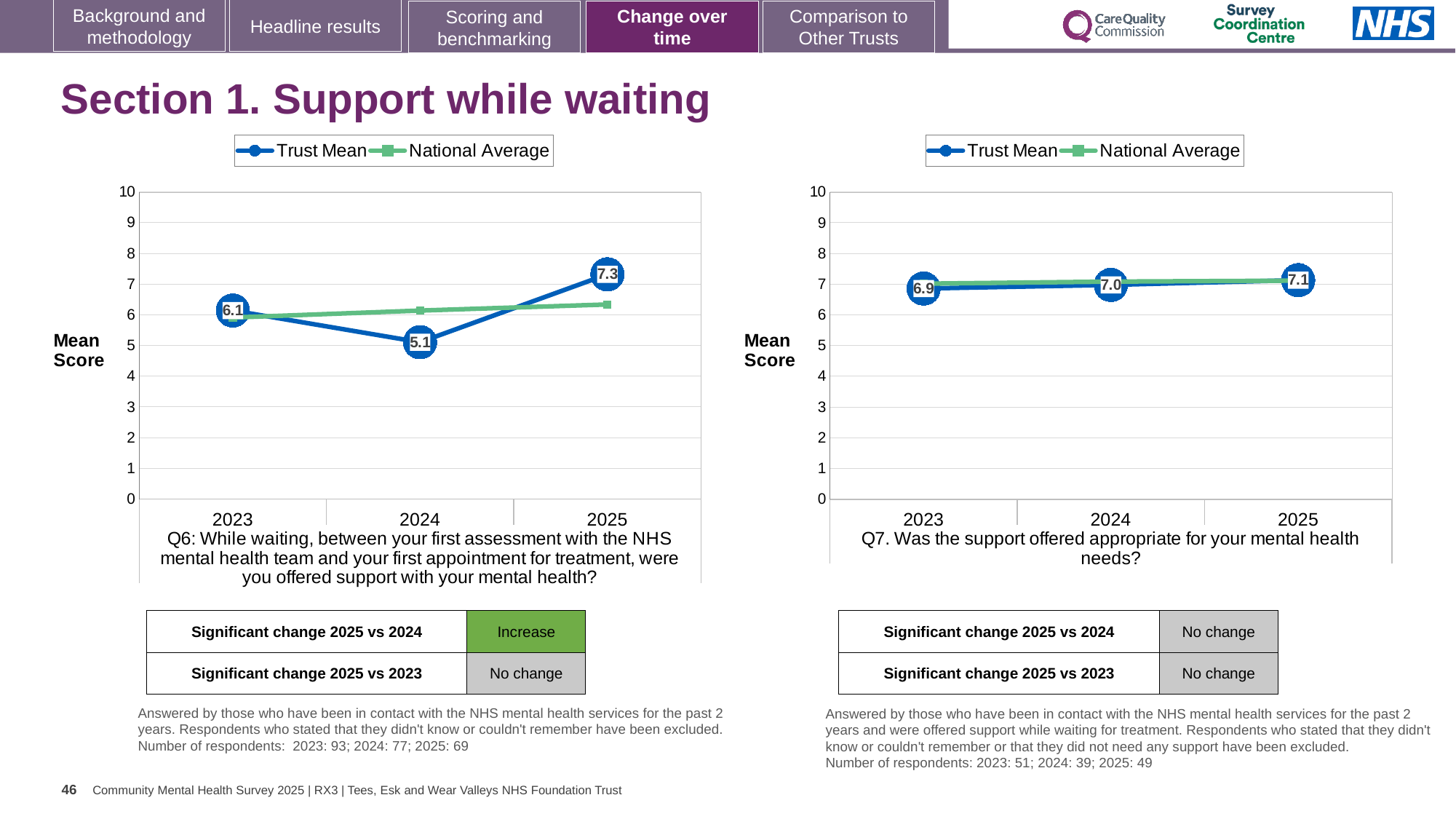
How many series does the legend of the Q6 chart on the left list? 2 In the Q6 chart on the left, what is the difference between the Trust Mean scores for 2025 and 2024? 2.2 In the Q6 chart on the left, is the Trust Mean score for 2023 or 2025 larger? 2025 How many years are shown on the x axis of the Q7 chart on the right? 3 In the Q6 chart on the left, which year has the highest Trust Mean score? 2025 In the Q6 chart on the left, which year has the lowest Trust Mean score? 2024 In the Q7 chart on the right, what is the Trust Mean score for 2023? 6.9 In the Q6 chart on the left, is the National Average value for 2024 greater or less than 7? less What kind of chart is the Q7 chart on the right? Line chart In the Q6 chart on the left, what is the Trust Mean score for 2025? 7.3 In the Q7 chart on the right, what is the difference between the Trust Mean scores for 2025 and 2023? 0.2 In the Q6 chart on the left, what is the Trust Mean score for 2024? 5.1